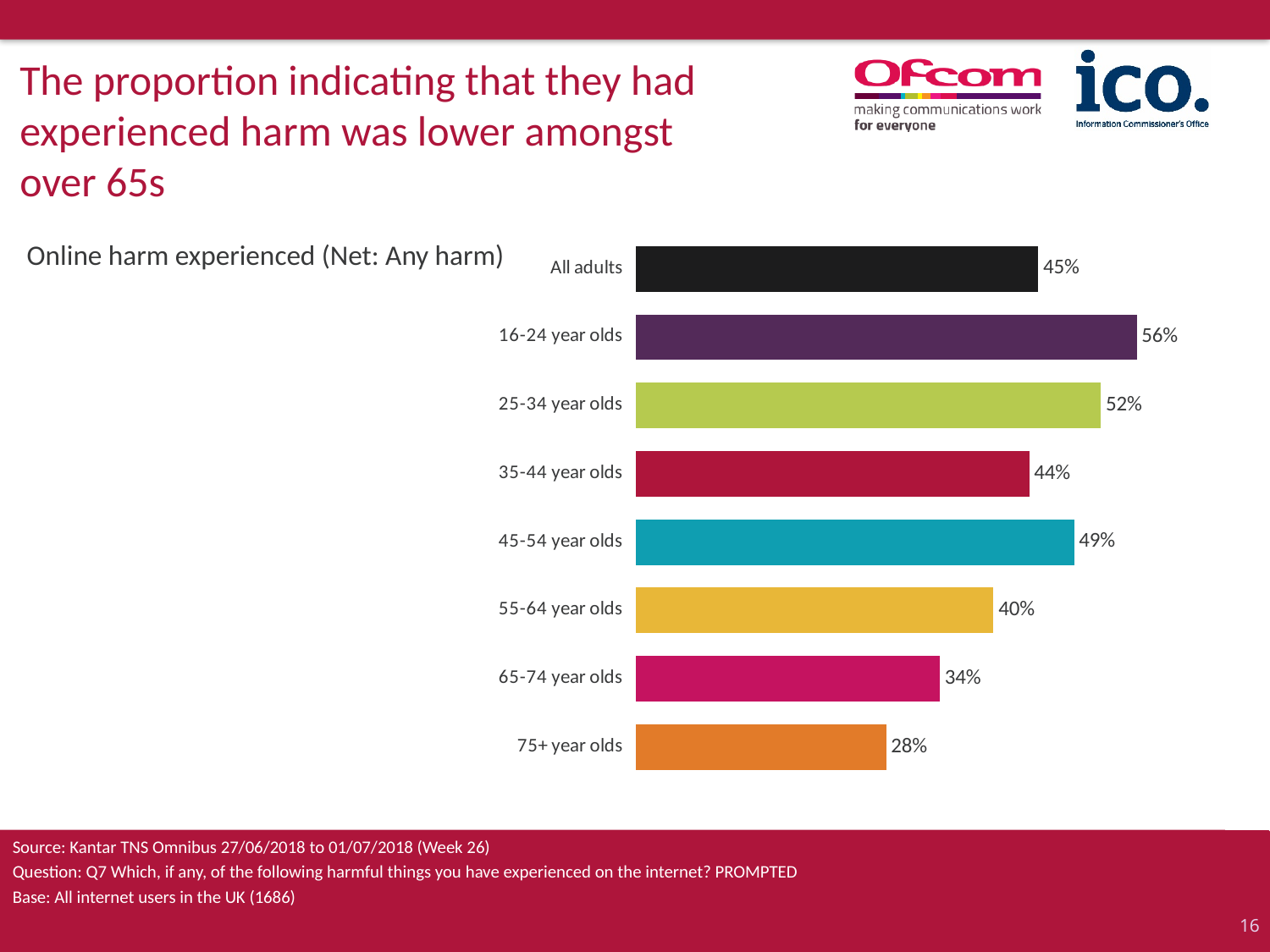
What percentage of 75+ year olds experienced online harm? 28% What is the value shown for All adults? 45% What is the title of the chart? Online harm experienced (Net: Any harm) What percentage of 16-24 year olds experienced online harm? 56% How many categories are shown on the chart? 8 What is the difference between the values for 16-24 year olds and 75+ year olds? 28% Which age group has the highest proportion experiencing online harm? 16-24 year olds What is the difference between the values for 45-54 year olds and 55-64 year olds? 9% Which category has the lowest value on the chart? 75+ year olds Which is larger, the value for 65-74 year olds or the value for 55-64 year olds? 55-64 year olds What kind of chart is shown on the slide? Bar chart Which is larger, the value for 35-44 year olds or the value for 45-54 year olds? 45-54 year olds